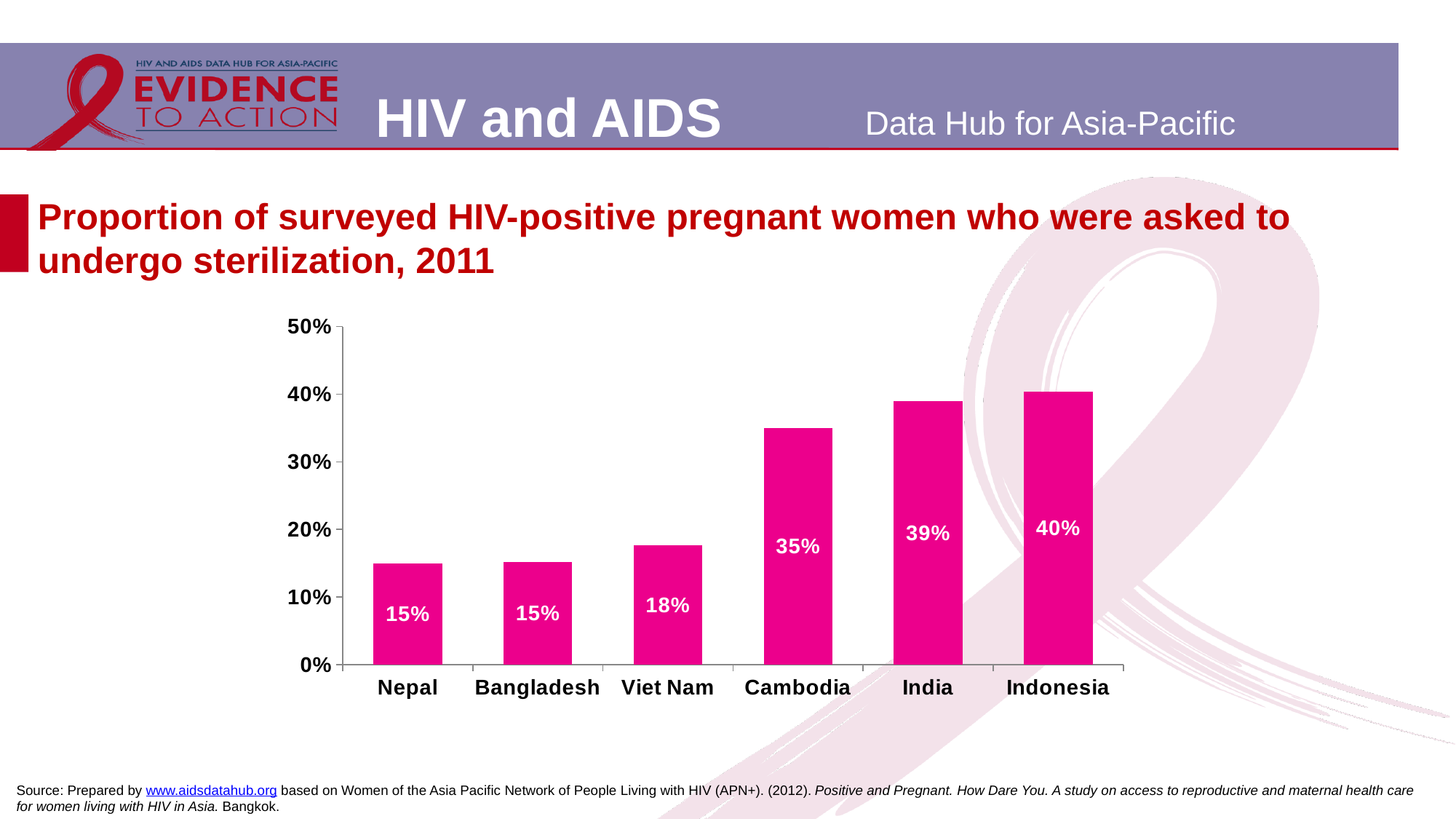
What is the difference between the values for Indonesia and Nepal? 25% What is the value for Viet Nam? 18% Which country has the highest proportion? Indonesia What kind of chart is shown on the slide? Bar chart What is the value for India? 39% What year does the chart title refer to? 2011 Is the value for India greater or less than 30%? greater Which is larger, the value for Cambodia or the value for Viet Nam? Cambodia What is the difference between the values for Cambodia and Viet Nam? 17% What is the value for Cambodia? 35% Do the values rise or fall from Nepal to Indonesia along the x axis? Rise How many countries are shown on the chart? 6